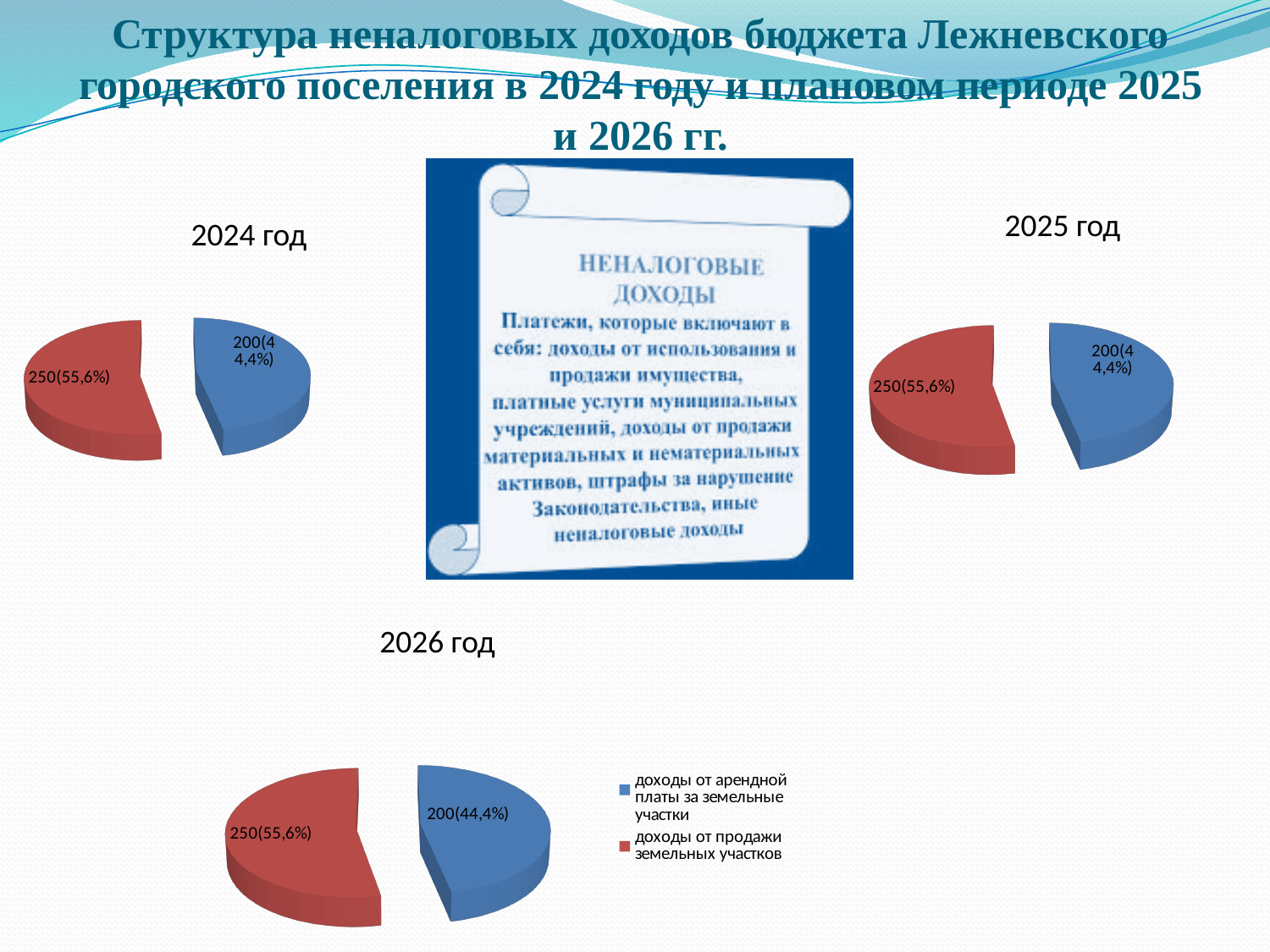
In the "2026 год" chart, which is larger: доходы от продажи земельных участков or доходы от арендной платы за земельные участки? доходы от продажи земельных участков In the "2024 год" chart, what value is shown for доходы от продажи земельных участков? 250(55,6%) In the "2024 год" chart, what value is shown for доходы от арендной платы за земельные участки? 200(44,4%) How many slices does the "2025 год" pie chart have? 2 In the "2026 год" chart, what share of the pie is доходы от арендной платы за земельные участки? 44,4% In the "2026 год" chart, which category has the largest slice? доходы от продажи земельных участков In the "2025 год" chart, which category has the smallest slice? доходы от арендной платы за земельные участки In the "2025 год" chart, what share of the pie is доходы от продажи земельных участков? 55,6% In the "2026 год" chart, what colour is the slice for доходы от продажи земельных участков? red What kind of chart is the "2024 год" chart? pie chart How many entries does the legend next to the "2026 год" chart list? 2 In the "2024 год" chart, what is the difference between the value for доходы от продажи земельных участков and the value for доходы от арендной платы за земельные участки? 50